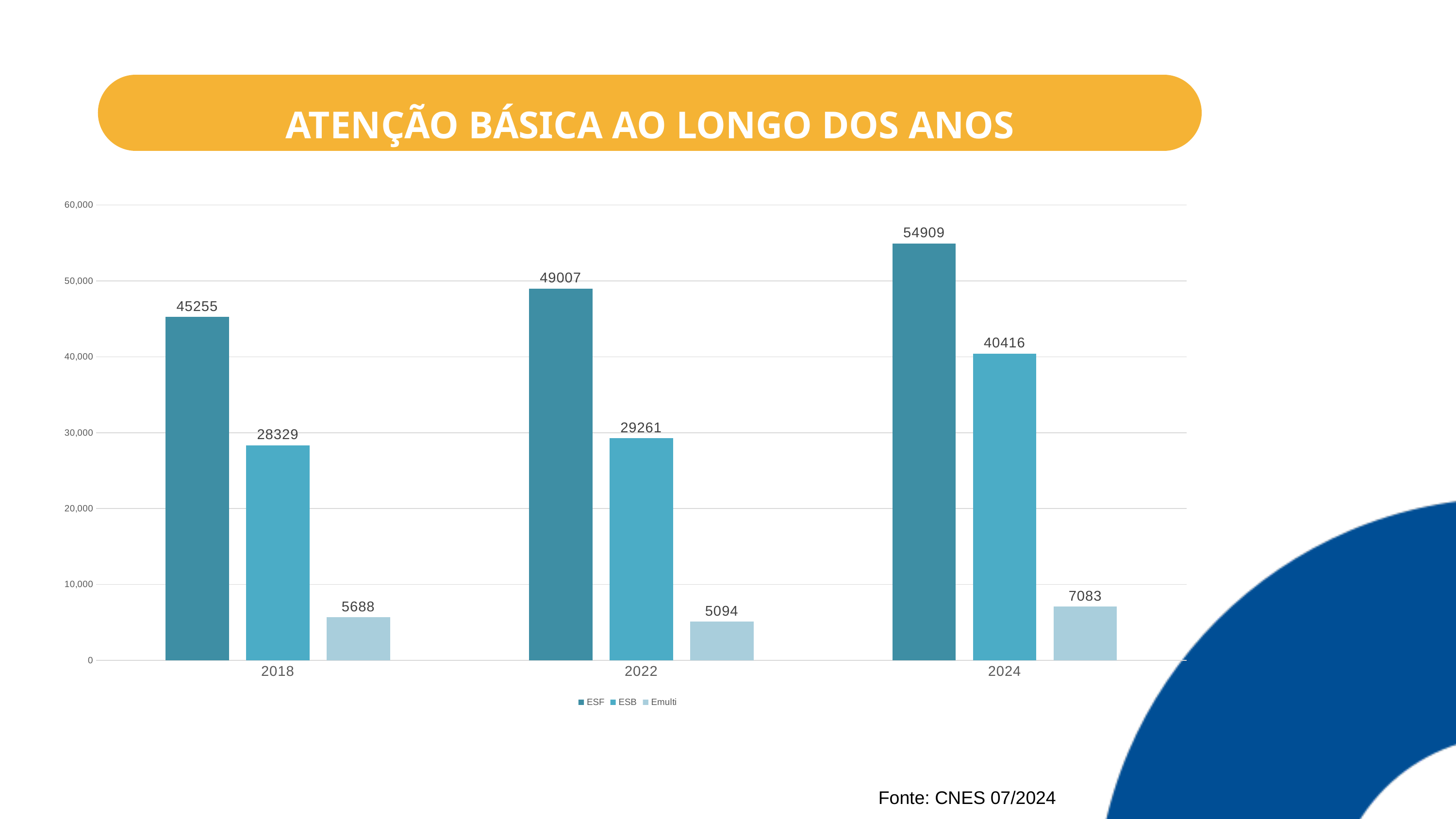
What is the difference between the ESB values for 2024 and 2022? 11155 What is the value for Emulti in 2022? 5094 How many series does the legend list? 3 What is the value for ESF in 2018? 45255 How many years are shown on the x axis? 3 In which year is the Emulti value lowest? 2022 What is the difference between the ESF values for 2024 and 2018? 9654 Which is larger, the ESB value in 2018 or the ESB value in 2022? ESB in 2022 Is the ESF value for 2022 greater or less than 50,000? less In which year is the ESF value highest? 2024 Does the ESF value rise or fall from 2018 to 2024? rise What is the value for ESB in 2024? 40416